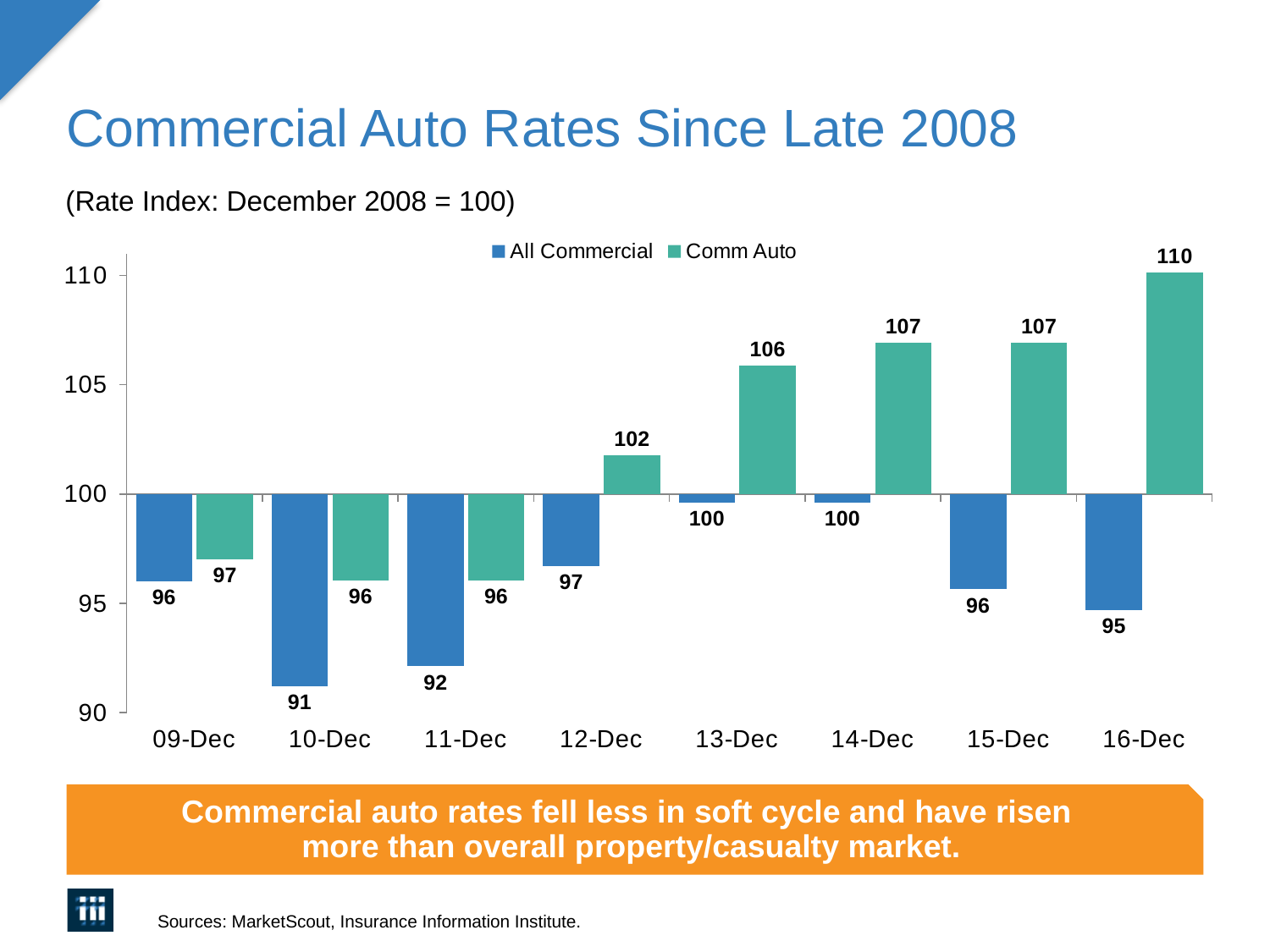
What kind of chart is shown on the slide? Bar chart Which category has the highest Comm Auto value? 16-Dec Which category has the lowest All Commercial value? 10-Dec How many series does the legend list? 2 What is the Comm Auto value for 16-Dec? 110 What is the title of the chart? Commercial Auto Rates Since Late 2008 What is the difference between the Comm Auto and All Commercial values for 16-Dec? 15 Does the Comm Auto series rise or fall from 12-Dec to 16-Dec? Rise What is the All Commercial value for 13-Dec? 100 What is the All Commercial value for 10-Dec? 91 Which is larger for 12-Dec, the All Commercial value or the Comm Auto value? Comm Auto How many categories are shown on the x axis? 8